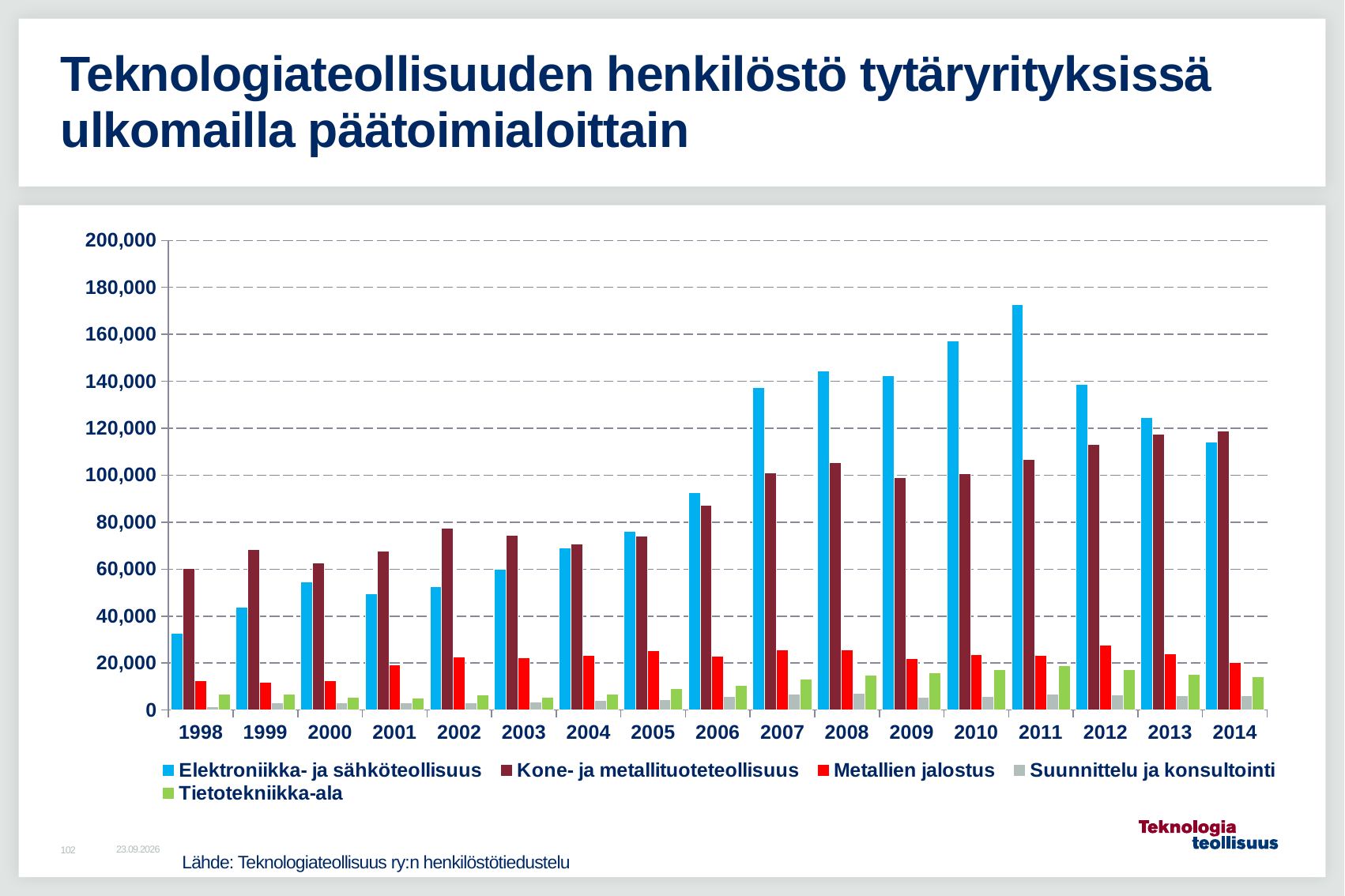
In 2011, which is larger: Elektroniikka- ja sähköteollisuus or Kone- ja metallituoteteollisuus? Elektroniikka- ja sähköteollisuus In 1998, which is larger: Elektroniikka- ja sähköteollisuus or Kone- ja metallituoteteollisuus? Kone- ja metallituoteteollisuus What kind of chart is shown on the slide? bar chart What colour represents Metallien jalostus in the legend? red Is the value for Elektroniikka- ja sähköteollisuus in 2011 greater or less than 160,000? greater In which year is the bar for Elektroniikka- ja sähköteollisuus the highest? 2011 In which year is the bar for Elektroniikka- ja sähköteollisuus the lowest? 1998 How many series does the legend list? 5 How many years are shown on the x axis? 17 Do the values for Elektroniikka- ja sähköteollisuus rise or fall from 2011 to 2014? fall Is the value for Kone- ja metallituoteteollisuus in 2014 greater or less than 100,000? greater Is the value for Elektroniikka- ja sähköteollisuus in 1998 greater or less than 40,000? less